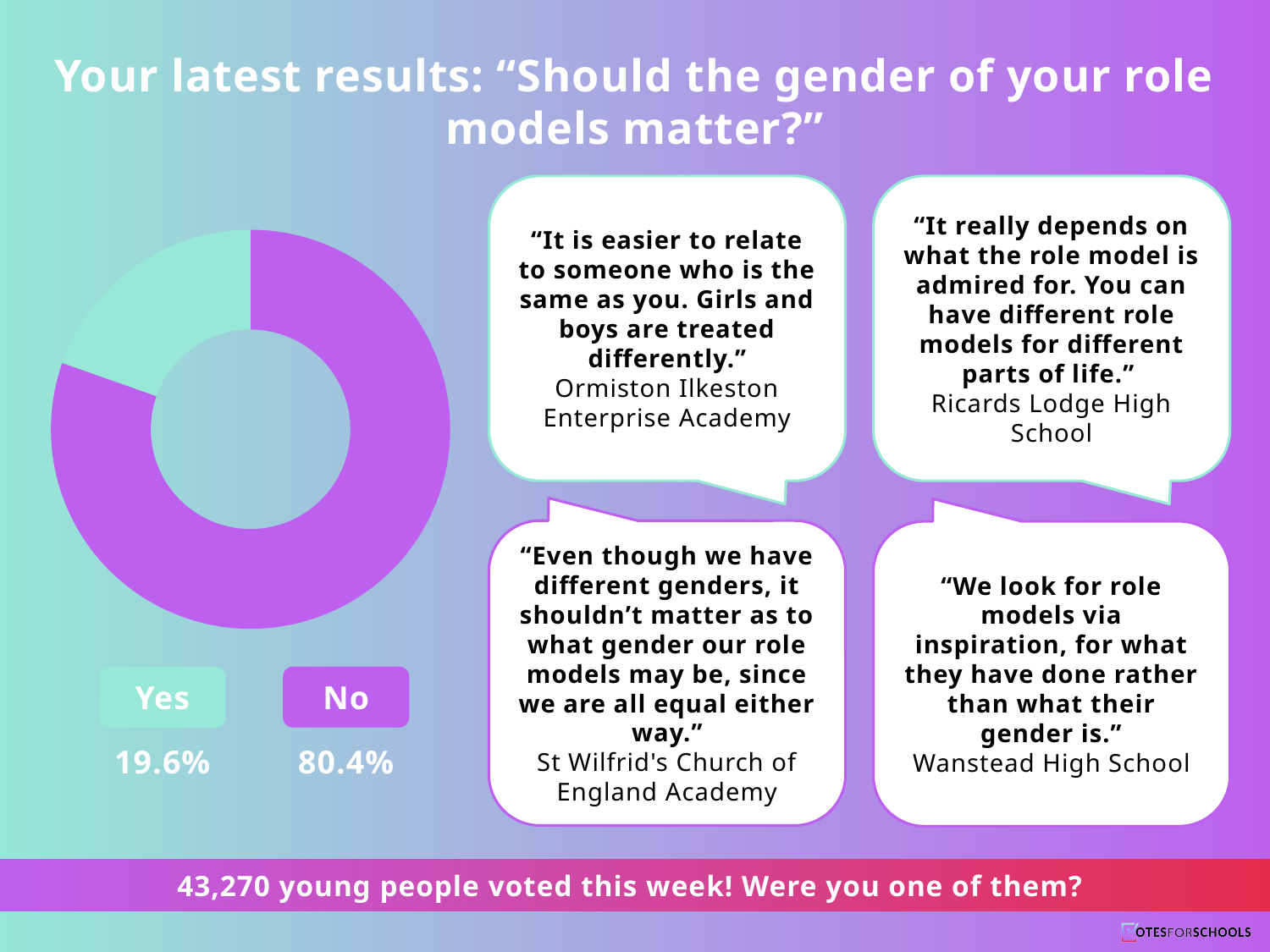
Which response received the larger share of votes? No What is the total of the two percentages shown in the chart? 100% Which response received the smaller share of votes? Yes What kind of chart is shown on the slide? Doughnut chart Is the share for "Yes" larger or smaller than the share for "No"? smaller What percentage of respondents answered "No"? 80.4% What colour represents the "No" response in the chart? Purple What is the difference in percentage points between the "No" and "Yes" responses? 60.8 What percentage of respondents answered "Yes"? 19.6% Is the value for "No" greater or less than 50%? greater What colour represents the "Yes" response in the chart? Light green How many categories does the chart show? 2